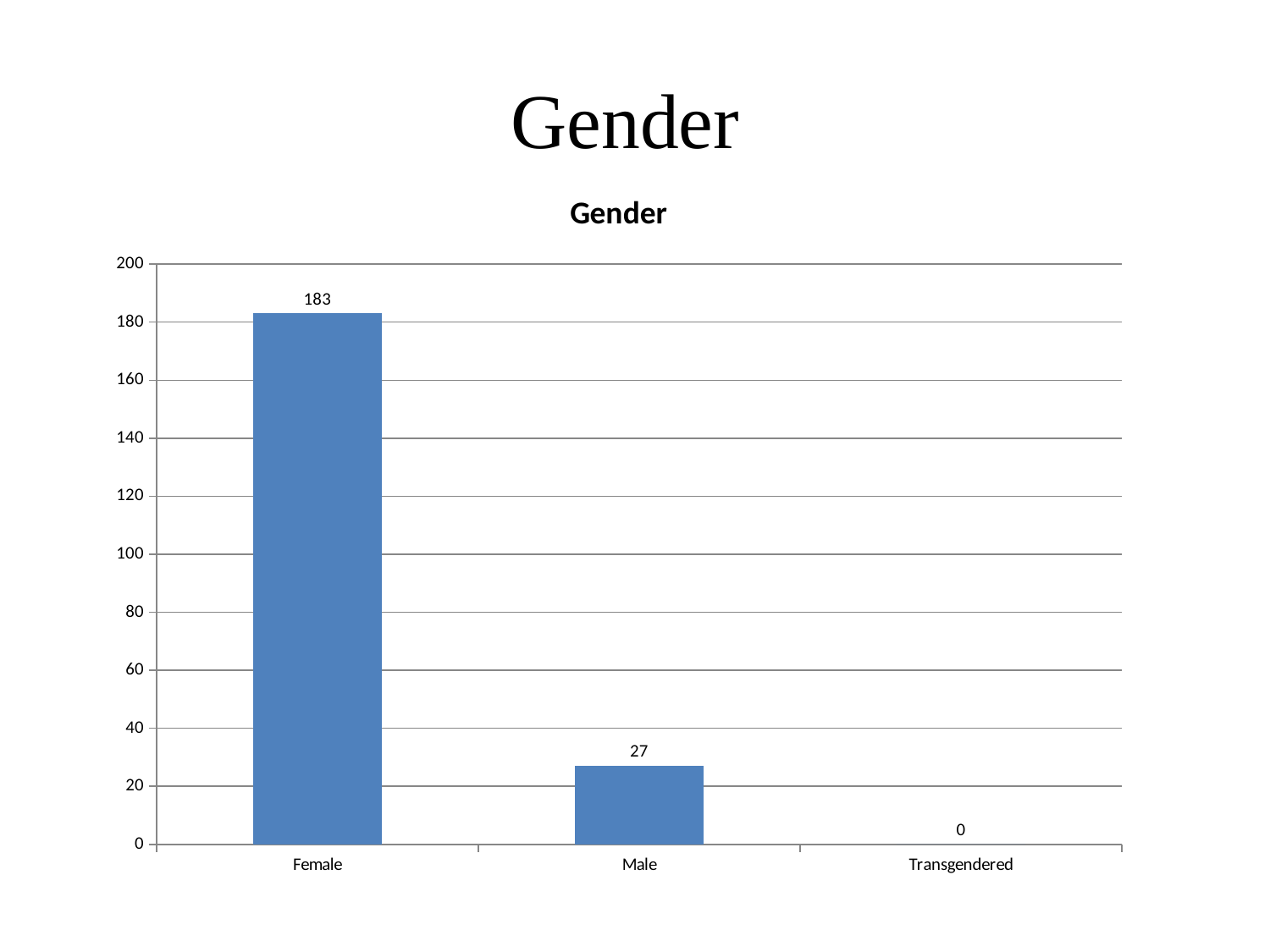
Is the value for Male greater or less than 40? less Is the value for Female greater or less than 160? greater What kind of chart is shown on the slide? bar chart Which category has the lowest value? Transgendered What is the value for Transgendered? 0 Which is larger, the value for Male or the value for Transgendered? Male What is the value for Female? 183 What is the value for Male? 27 What is the title of the chart? Gender How many categories are shown on the x axis? 3 Which category has the highest value? Female What is the difference between the values for Female and Male? 156